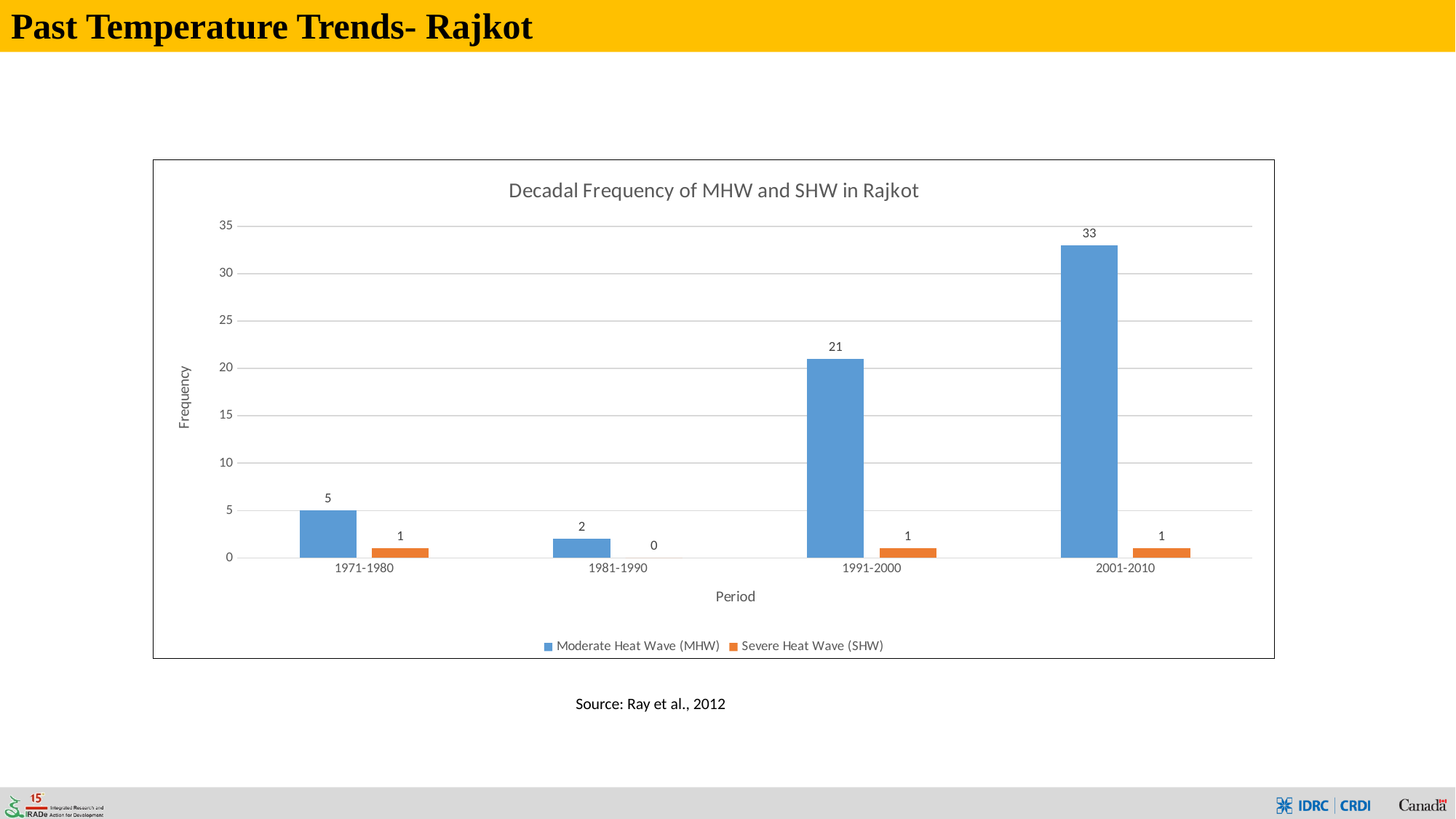
What is the title of the chart? Decadal Frequency of MHW and SHW in Rajkot What is the difference between the MHW frequency in 2001-2010 and in 1991-2000? 12 What is the Severe Heat Wave (SHW) frequency for 1981-1990? 0 How many periods are shown on the x axis? 4 What is the Moderate Heat Wave (MHW) frequency for 2001-2010? 33 Does the Moderate Heat Wave (MHW) frequency rise or fall from 1981-1990 to 2001-2010? Rise What is the Moderate Heat Wave (MHW) frequency for 1991-2000? 21 Which is larger, the MHW frequency for 1971-1980 or for 1981-1990? 1971-1980 What kind of chart is shown on the slide? Bar chart Which period has the lowest Moderate Heat Wave (MHW) frequency? 1981-1990 How many series does the legend list? 2 Which period has the highest Moderate Heat Wave (MHW) frequency? 2001-2010